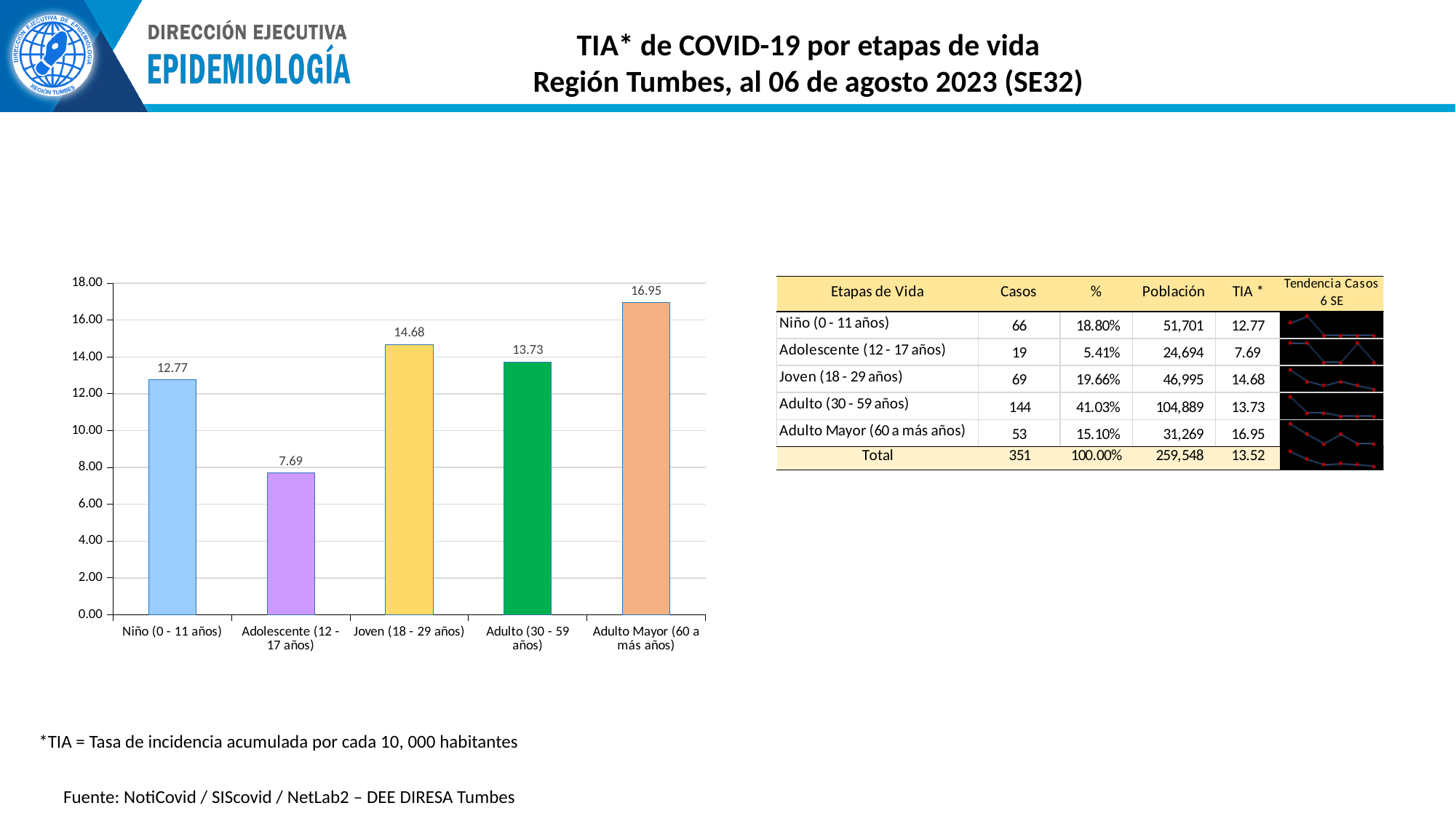
What is the TIA value shown for Adulto Mayor (60 a más años)? 16.95 What is the TIA value shown for Adolescente (12 - 17 años)? 7.69 What is the difference between the TIA for Joven (18 - 29 años) and Adulto (30 - 59 años)? 0.95 Which life stage has the lowest TIA in the bar chart? Adolescente (12 - 17 años) What kind of chart is used to show the TIA by life stage? Bar chart What is the maximum value shown on the vertical axis of the bar chart? 18.00 Is the TIA value for Adulto (30 - 59 años) greater or less than 12.00? greater What is the TIA value shown for Niño (0 - 11 años)? 12.77 How many life-stage categories are plotted in the bar chart? 5 What is the difference between the TIA for Adulto Mayor (60 a más años) and Adolescente (12 - 17 años)? 9.26 Which has a larger TIA, Niño (0 - 11 años) or Joven (18 - 29 años)? Joven (18 - 29 años) Which life stage has the highest TIA in the bar chart? Adulto Mayor (60 a más años)